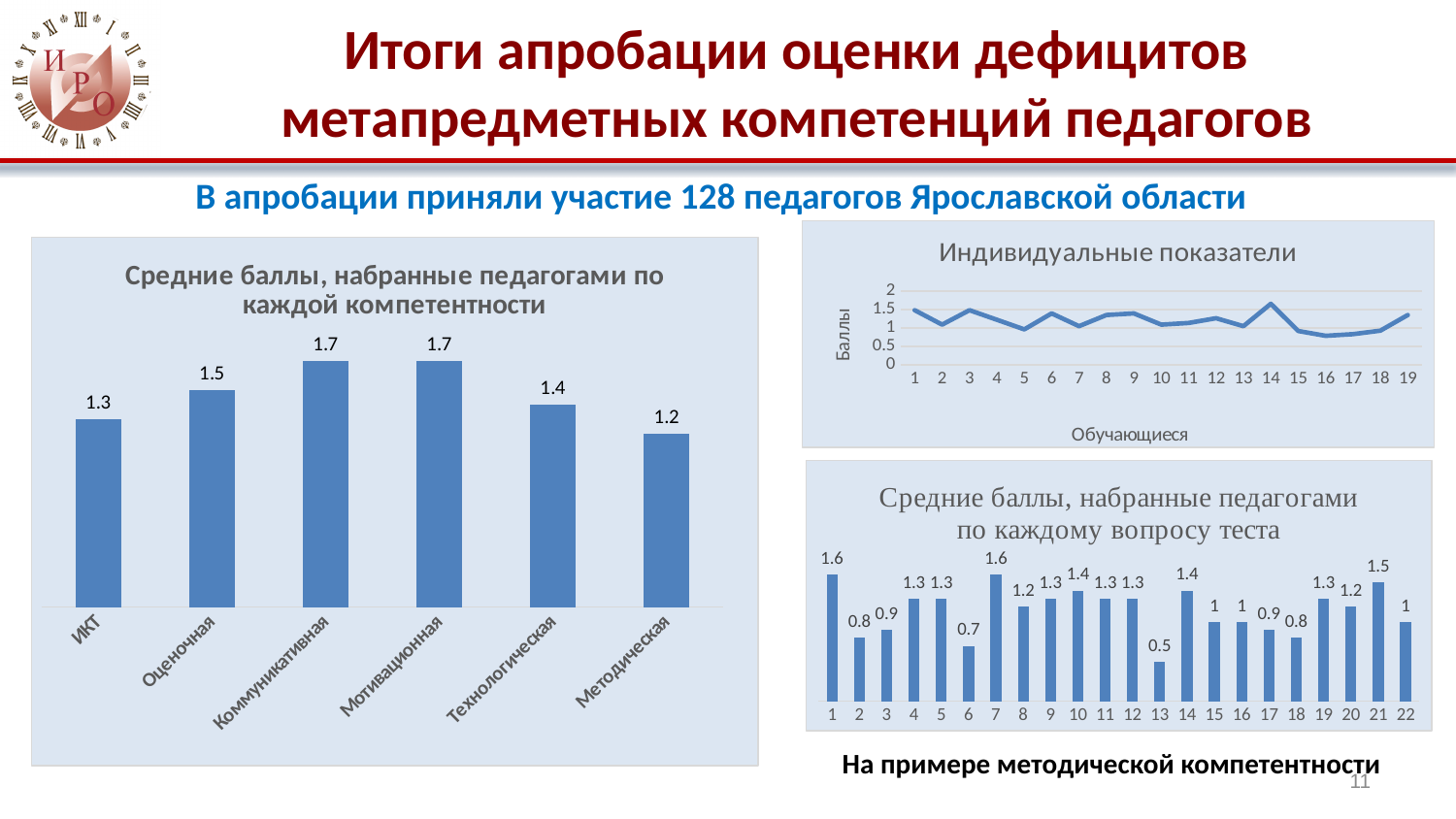
In the chart 'Средние баллы, набранные педагогами по каждой компетентности', what is the difference between the values for Коммуникативная and ИКТ? 0.4 What type of chart is 'Индивидуальные показатели'? line chart In the chart 'Средние баллы, набранные педагогами по каждому вопросу теста', what is the difference between the values for question 21 and question 6? 0.8 In the chart 'Средние баллы, набранные педагогами по каждой компетентности', how many competencies are shown? 6 In the chart 'Средние баллы, набранные педагогами по каждой компетентности', which is larger: Технологическая or Методическая? Технологическая In the chart 'Индивидуальные показатели', is the value for point 14 greater or less than 1.5? greater In the chart 'Средние баллы, набранные педагогами по каждому вопросу теста', what is the value for question 13? 0.5 In the chart 'Индивидуальные показатели', how many points are plotted along the x axis? 19 In the chart 'Средние баллы, набранные педагогами по каждой компетентности', which competency has the lowest average score? Методическая In the chart 'Средние баллы, набранные педагогами по каждому вопросу теста', how many questions are shown? 22 In the chart 'Индивидуальные показатели', is the value for point 16 greater or less than 1? less In the chart 'Средние баллы, набранные педагогами по каждой компетентности', what is the value for Оценочная? 1.5